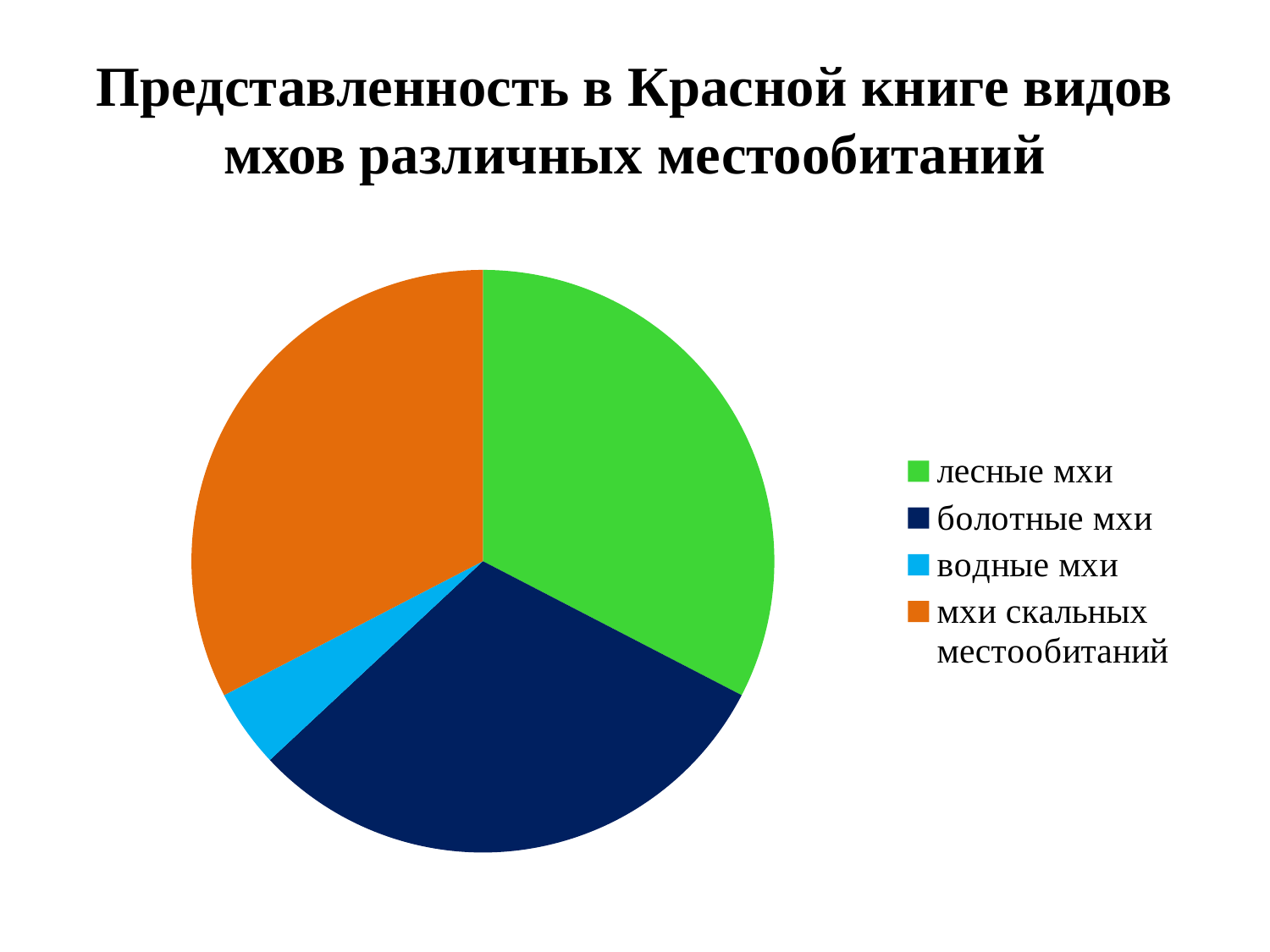
What kind of chart is shown on the slide? pie chart What is the title of the slide? Представленность в Красной книге видов мхов различных местообитаний How many categories (slices) does the pie chart have? 4 Which slice is larger: водные мхи or мхи скальных местообитаний? мхи скальных местообитаний Which slice is larger: водные мхи or лесные мхи? лесные мхи What colour is the slice for мхи скальных местообитаний? orange Which category has the smallest slice of the pie? водные мхи How many entries does the legend list? 4 Which slice is larger: водные мхи or болотные мхи? болотные мхи